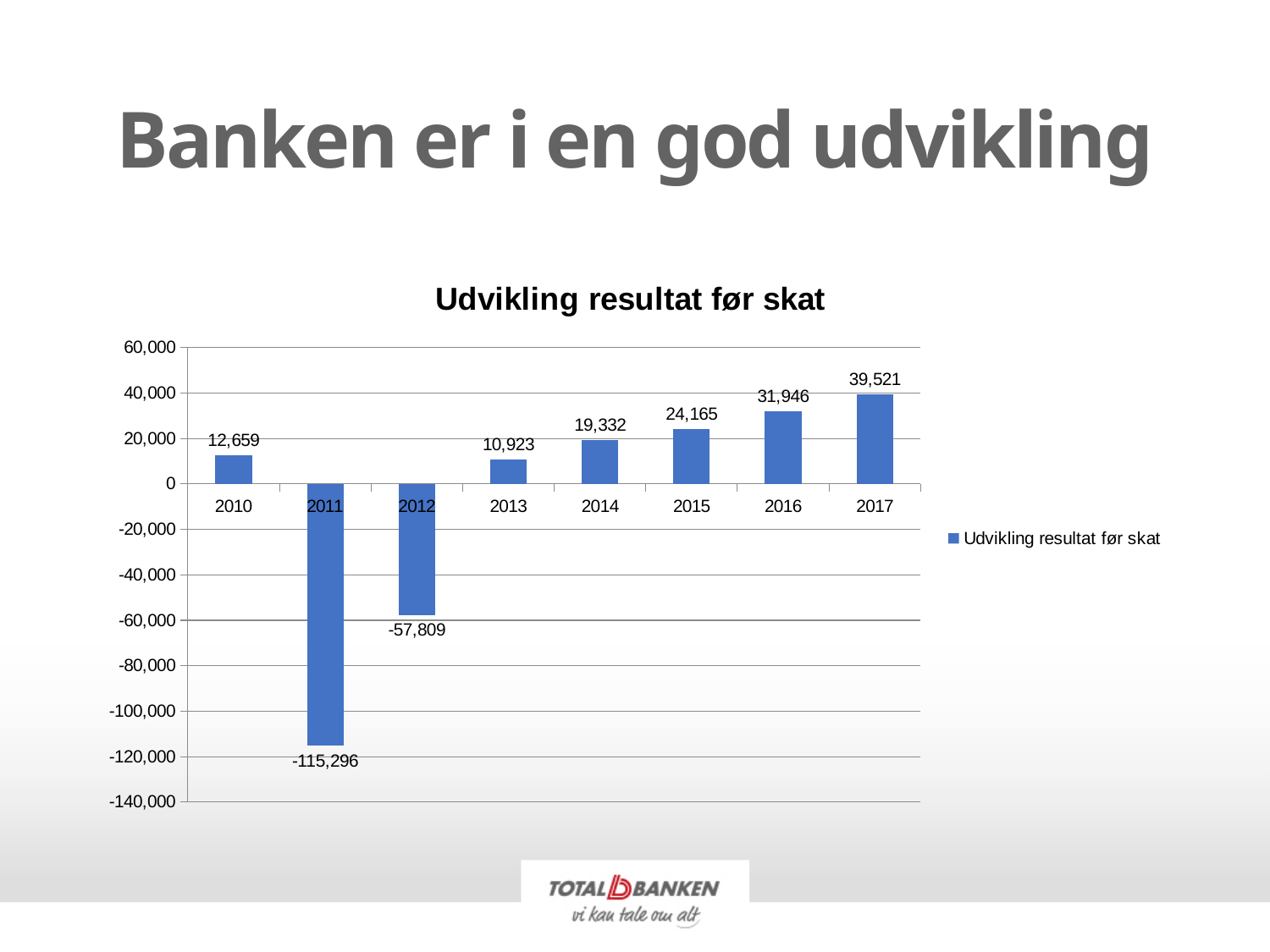
What is the value for 2013? 10,923 Which is larger, the value for 2010 or the value for 2013? 2010 How many series does the legend list? 1 What is the title of the chart? Udvikling resultat før skat Do the values rise or fall from 2013 to 2017? rise How many years are shown on the x axis? 8 What is the value for 2017? 39,521 What kind of chart is shown? bar chart What is the value for 2011? -115,296 Which year has the lowest value? 2011 Which year has the highest value? 2017 What is the difference between the values for 2017 and 2016? 7,575